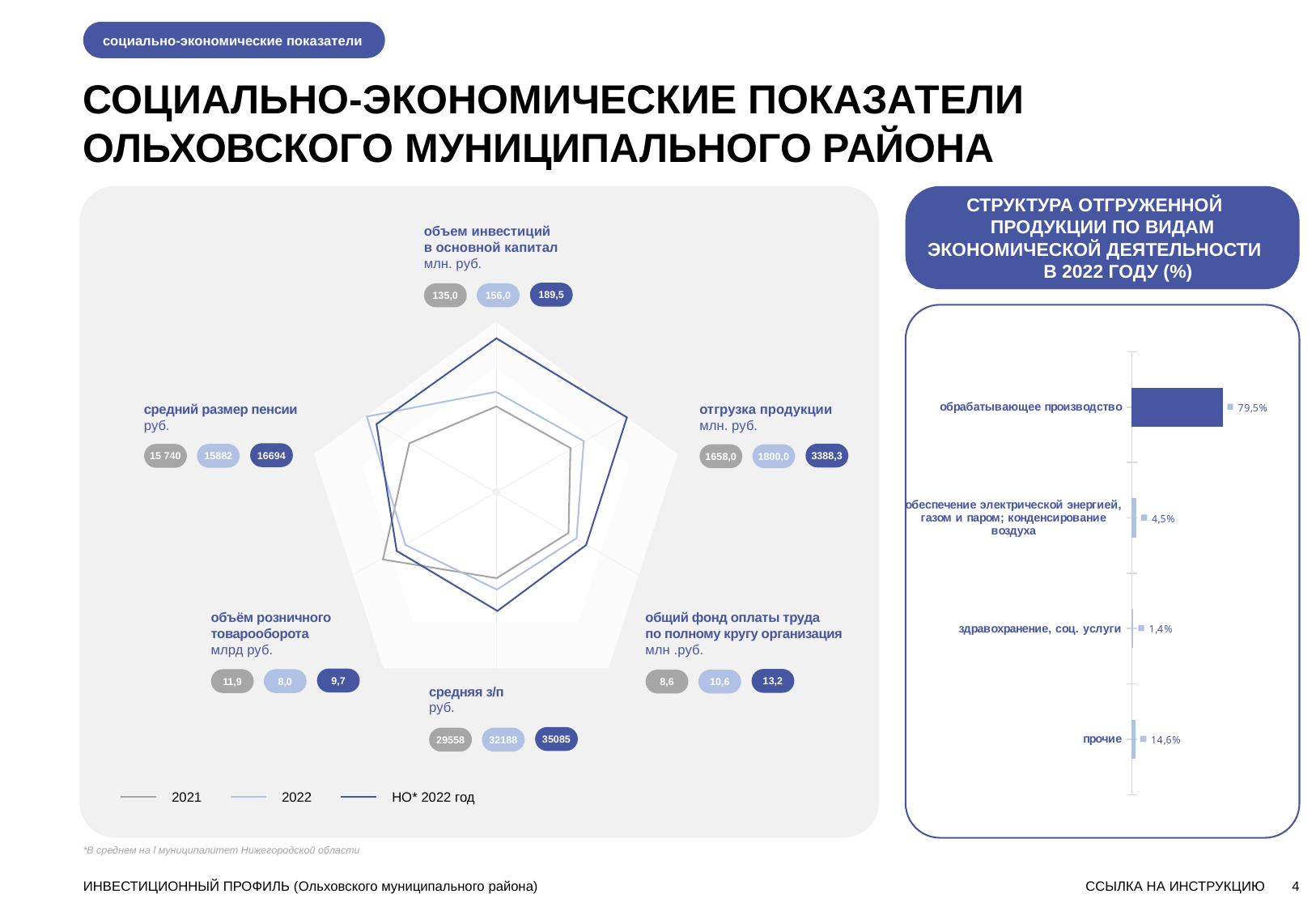
On the bar chart on the right, what is the value for здравоохранение, соц. услуги? 1,4% What kind of chart is the chart on the left side of the slide? radar chart On the radar chart on the left, which is larger for объём розничного товарооборота: the 2021 value or the 2022 value? 2021 On the radar chart on the left, what is the difference between the 2022 and 2021 values for объем инвестиций в основной капитал? 21,0 On the radar chart on the left, what is the НО* 2022 год value for отгрузка продукции? 3388,3 On the bar chart on the right, what is the difference between прочие and обеспечение электрической энергией, газом и паром; кондиционирование воздуха? 10,1% On the bar chart on the right, which category has the lowest value? здравоохранение, соц. услуги On the bar chart on the right, how many categories are shown? 4 On the bar chart on the right, which category has the highest value? обрабатывающее производство On the radar chart on the left, what is the 2022 value for средняя з/п? 32188 On the radar chart on the left, how many series does the legend list? 3 On the bar chart on the right, what is the value for обрабатывающее производство? 79,5%